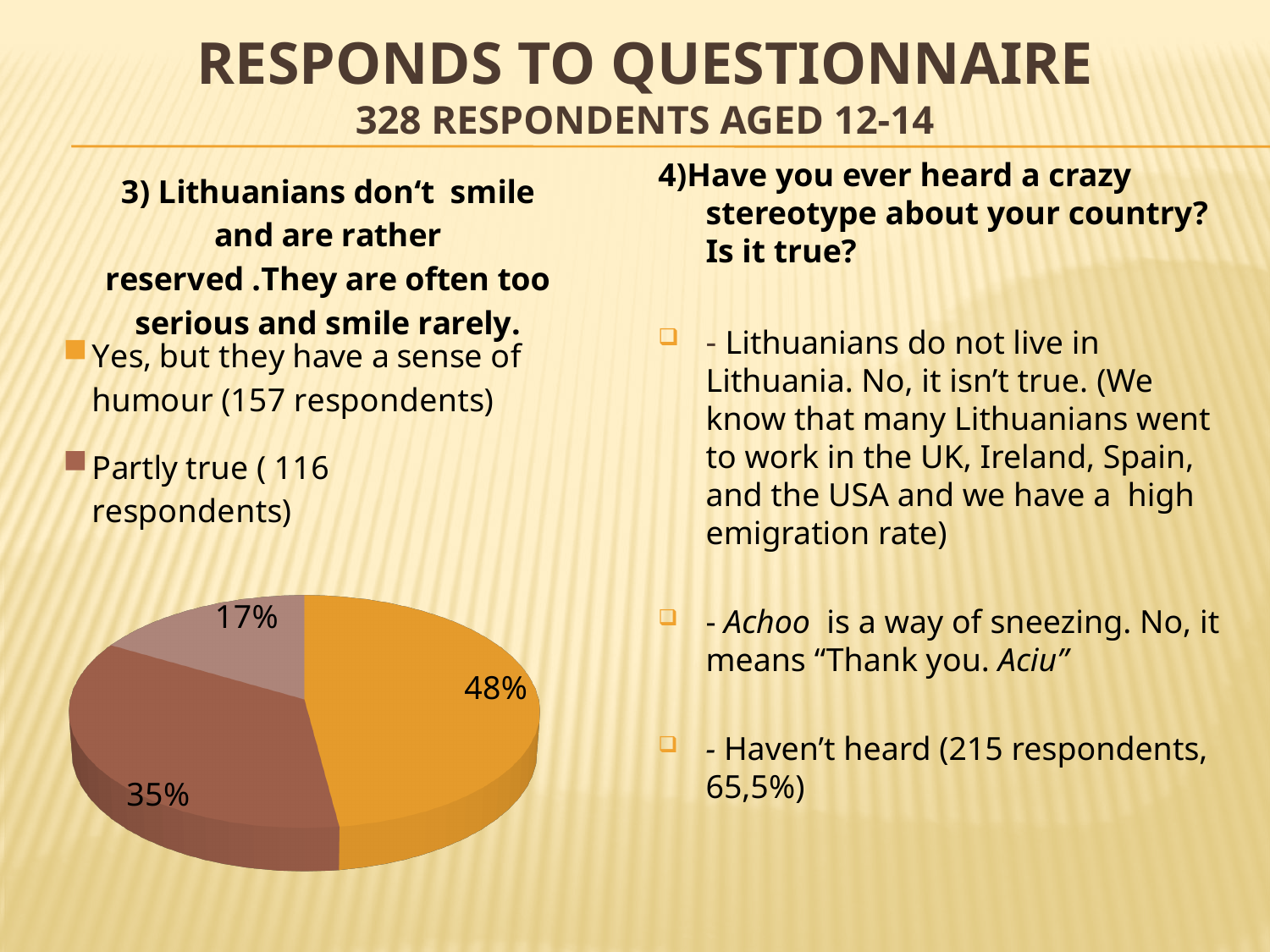
Which slice is larger in the pie chart: 'Yes, but they have a sense of humour' or 'Partly true'? Yes, but they have a sense of humour What is the difference in percentage points between the 'Yes, but they have a sense of humour' slice and the 'Partly true' slice? 13 What percentage of the pie chart does the 'Yes, but they have a sense of humour' slice represent? 48% How many entries does the pie chart's legend list? 2 What kind of chart is shown on the slide? pie chart What is the percentage of the smallest slice in the pie chart? 17% What colour is the largest slice of the pie chart? orange Which legend category has the largest slice in the pie chart? Yes, but they have a sense of humour (157 respondents) What percentage of the pie chart does the 'Partly true' slice represent? 35% How many slices does the pie chart have? 3 What is the difference in percentage points between the largest slice and the smallest slice of the pie chart? 31 How many respondents does the legend give for the 'Partly true' category? 116